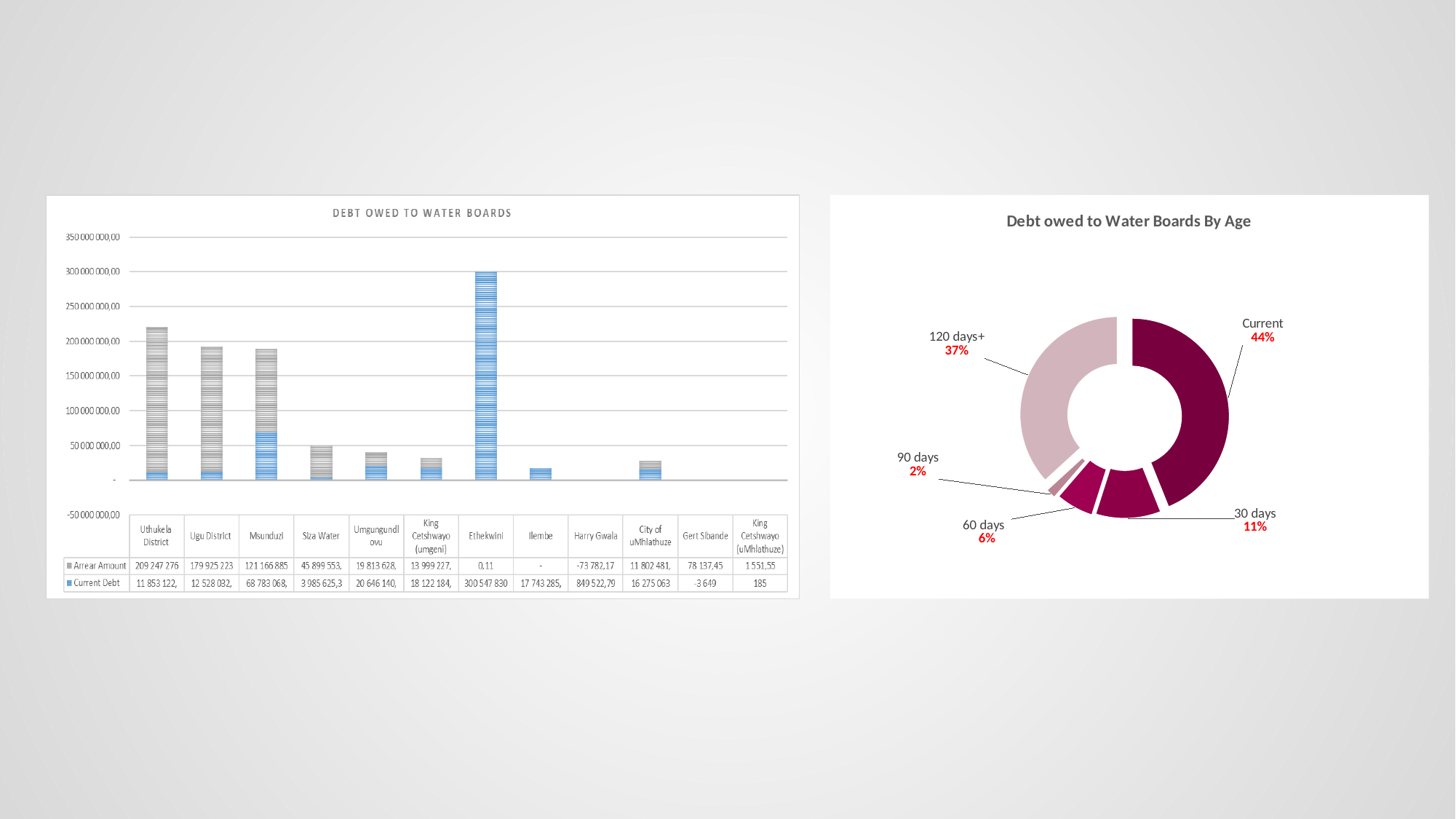
In the 'DEBT OWED TO WATER BOARDS' chart, what is the Current Debt for Gert Sibande? -3 649 In the 'DEBT OWED TO WATER BOARDS' chart, what is the Current Debt for Ethekwini? 300 547 830 In the 'DEBT OWED TO WATER BOARDS' chart, which has the larger Arrear Amount, Ugu District or Msunduzi? Ugu District In the 'DEBT OWED TO WATER BOARDS' chart, what is the Arrear Amount for Uthukela District? 209 247 276 What type of chart is 'DEBT OWED TO WATER BOARDS' on the left of the slide? Stacked bar chart How many series does the legend of the 'DEBT OWED TO WATER BOARDS' chart list? 2 In the 'Debt owed to Water Boards By Age' doughnut chart, what share of the debt is Current? 44% How many age categories are shown in the 'Debt owed to Water Boards By Age' doughnut chart? 5 In the 'Debt owed to Water Boards By Age' doughnut chart, how many percentage points larger is the 120 days+ share than the 30 days share? 26 percentage points In the 'Debt owed to Water Boards By Age' doughnut chart, which age category has the smallest share? 90 days In the 'Debt owed to Water Boards By Age' doughnut chart, which age category has the largest share? Current In the 'DEBT OWED TO WATER BOARDS' chart, which municipality has the highest Current Debt? Ethekwini